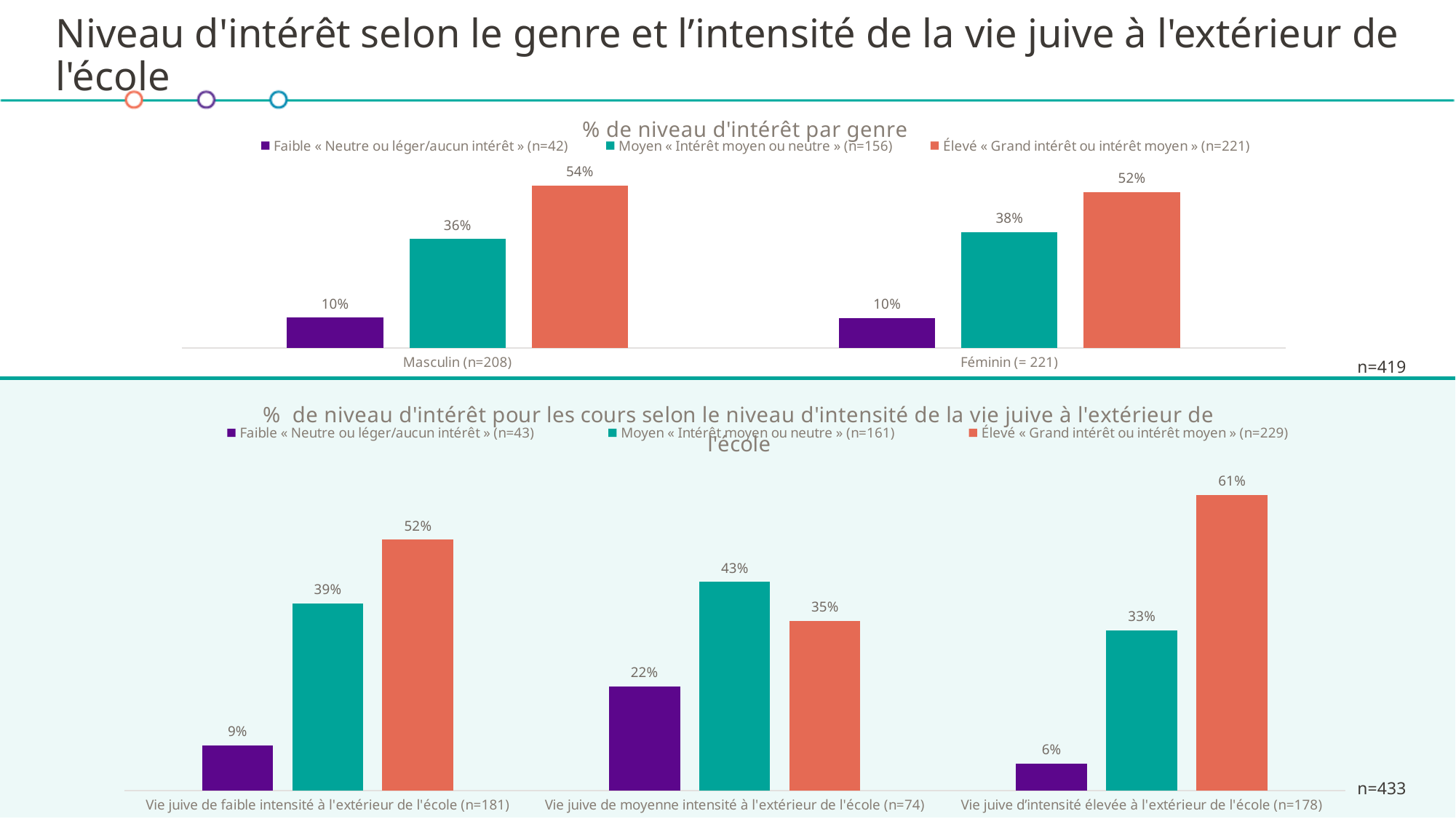
In the bottom chart, which category has the highest Moyen value? Vie juive de moyenne intensité à l'extérieur de l'école (n=74) In the top chart '% de niveau d'intérêt par genre', what kind of chart is shown? Bar chart In the bottom chart, is the Moyen value or the Élevé value larger for 'Vie juive de moyenne intensité à l'extérieur de l'école (n=74)'? Moyen In the bottom chart, what is the difference between the Élevé values for 'Vie juive d'intensité élevée' and 'Vie juive de moyenne intensité'? 26% In the top chart '% de niveau d'intérêt par genre', what is the value for Moyen for Féminin (= 221)? 38% In the top chart '% de niveau d'intérêt par genre', how many series does the legend list? 3 In the bottom chart, how many categories are shown on the x axis? 3 In the bottom chart, what is the Élevé value for 'Vie juive d'intensité élevée à l'extérieur de l'école (n=178)'? 61% In the top chart '% de niveau d'intérêt par genre', what is the value for Élevé for Masculin (n=208)? 54% In the bottom chart, which category has the lowest Faible value? Vie juive d'intensité élevée à l'extérieur de l'école (n=178) In the bottom chart, what is the Faible value for 'Vie juive de moyenne intensité à l'extérieur de l'école (n=74)'? 22% In the top chart '% de niveau d'intérêt par genre', what is the difference between the Élevé values for Masculin and Féminin? 2%